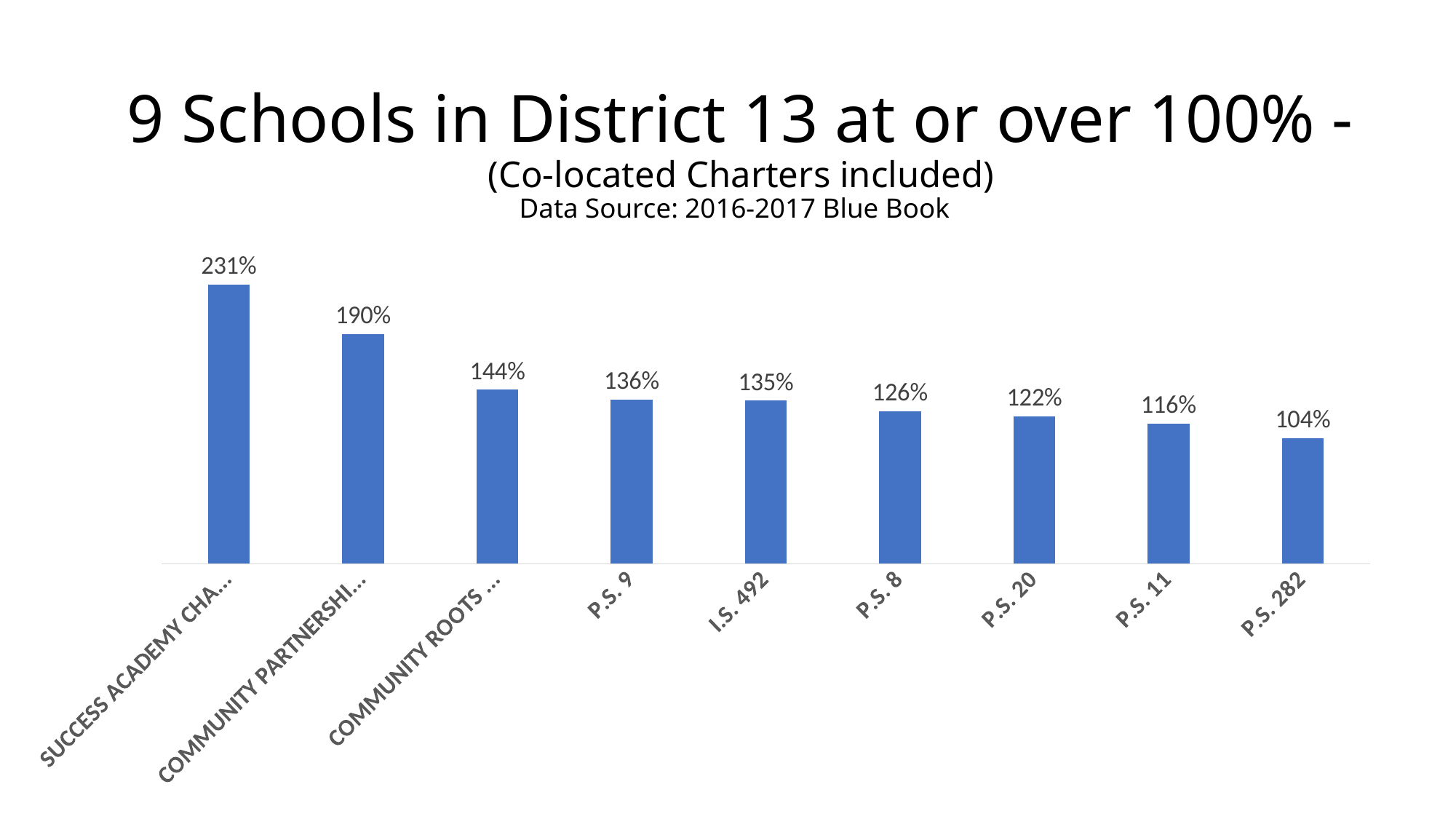
What is the value for P.S. 282? 104% What is the difference between the values for P.S. 9 and P.S. 282? 32% What is the value for I.S. 492? 135% What is the value for P.S. 9? 136% Which is larger, the value for P.S. 8 or the value for P.S. 20? P.S. 8 Do the values rise or fall from left to right along the x axis? Fall Which school has the highest value? Success Academy Cha... What is the value for P.S. 20? 122% Which school has the lowest value? P.S. 282 What is the difference between the values for P.S. 8 and P.S. 11? 10% What kind of chart is shown on the slide? Bar chart How many schools are shown in the chart? 9